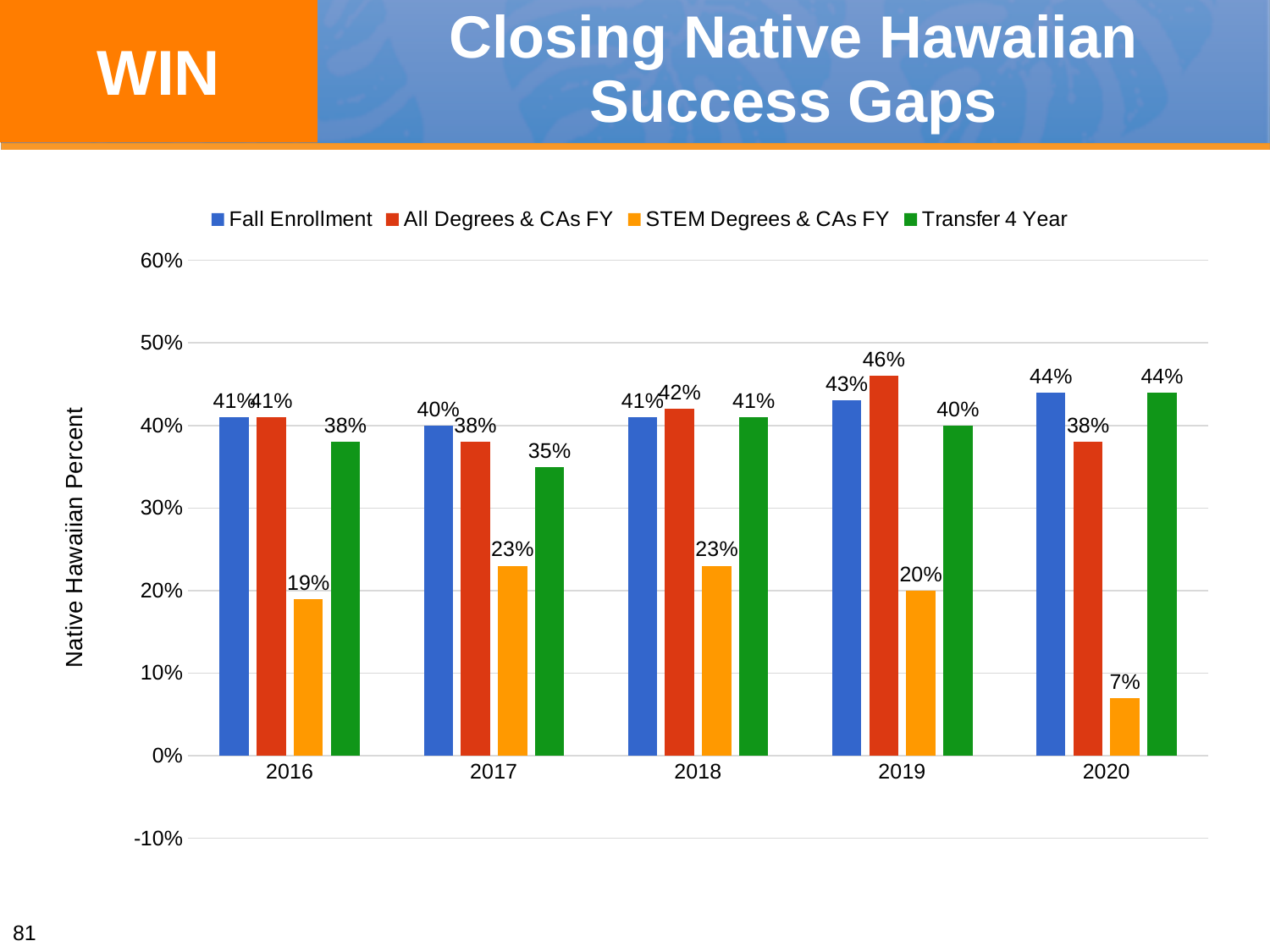
What kind of chart is shown on the slide? Bar chart How many series does the legend list? 4 What is the difference between the Transfer 4 Year value and the STEM Degrees & CAs FY value in 2020? 37% Which is larger in 2018: the All Degrees & CAs FY value or the Transfer 4 Year value? All Degrees & CAs FY What is the Transfer 4 Year value for 2017? 35% In which year is the STEM Degrees & CAs FY value lowest? 2020 In which year is the All Degrees & CAs FY value highest? 2019 What is the Fall Enrollment value for 2020? 44% How many years are shown on the x axis? 5 What is the All Degrees & CAs FY value for 2019? 46% What is the STEM Degrees & CAs FY value for 2016? 19% What is the label of the vertical axis? Native Hawaiian Percent